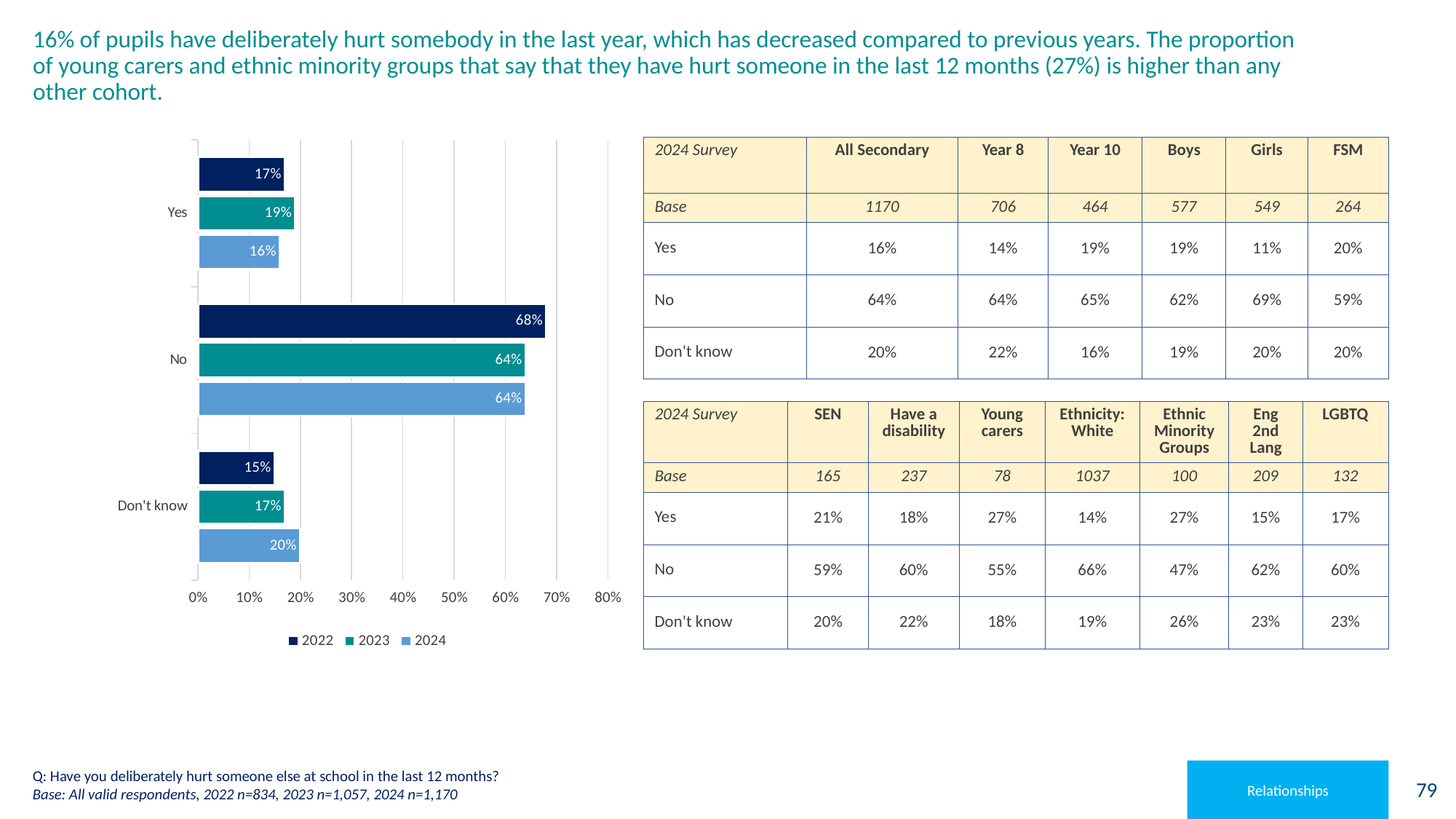
Which category has the lowest value in the 2022 series? Don't know How many series does the legend list? 3 What is the value for 'Don't know' in the 2023 series? 17% What is the value for 'No' in the 2022 series? 68% Is the 2023 value for 'No' greater or less than 50%? greater What is the difference between the 2022 and 2024 values for 'No'? 4% What is the value for 'Yes' in the 2024 series? 16% Which is larger for 'Don't know': the 2022 value or the 2024 value? 2024 Which series is shown in the darkest colour in the legend? 2022 How many categories are shown on the chart? 3 Which category has the highest value in the 2024 series? No What kind of chart is shown on the slide? Bar chart